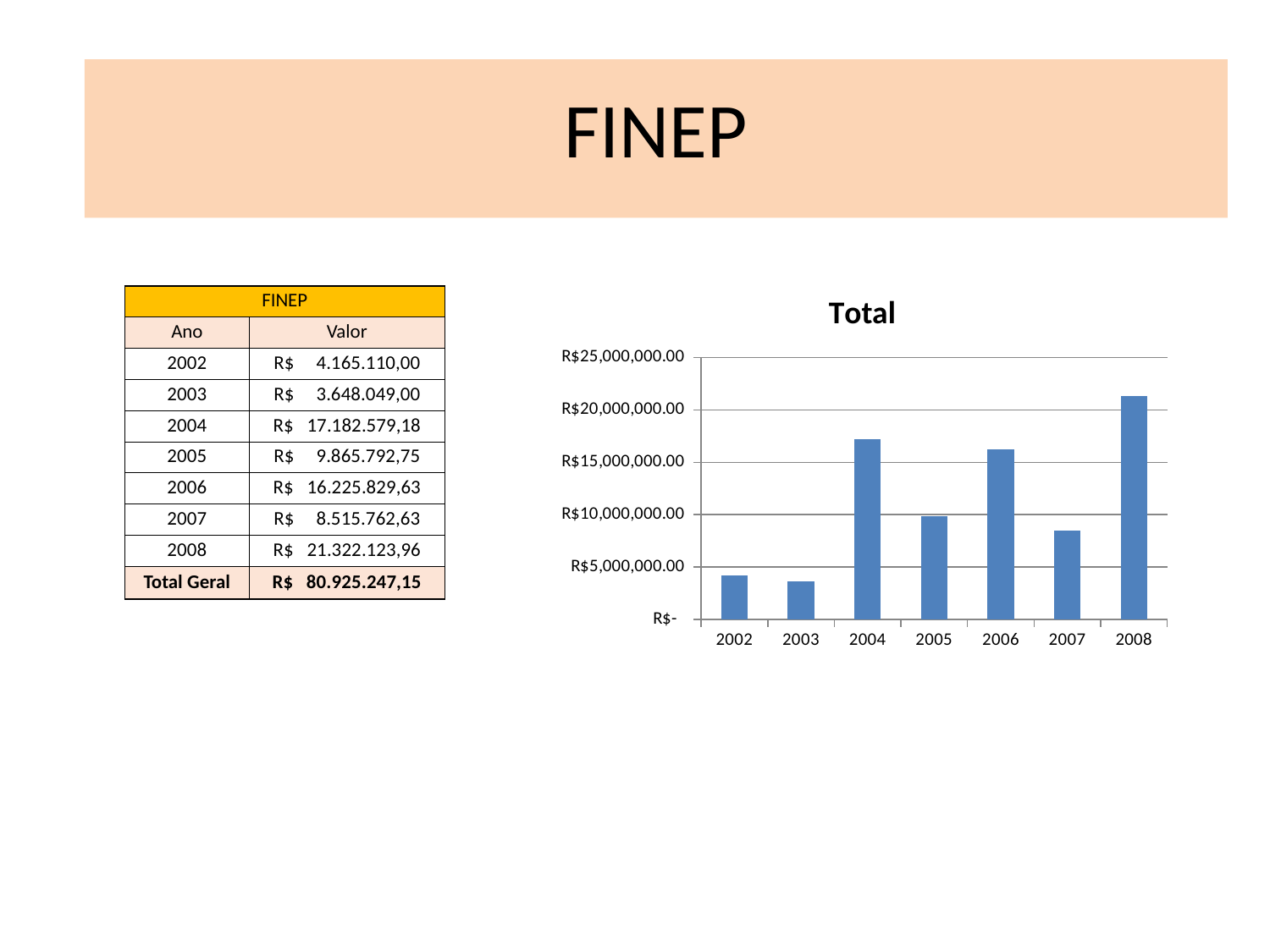
How many years are plotted on the chart? 7 What is the value for 2004? R$ 17.182.579,18 Is the value for 2007 greater or less than R$10,000,000.00? less What is the value for 2008? R$ 21.322.123,96 Which year has the lowest value in the chart? 2003 What kind of chart is shown on the slide? bar chart What is the value for 2002? R$ 4.165.110,00 What is the title of the chart? Total Which is larger, the value for 2004 or the value for 2006? 2004 Which year has the highest value in the chart? 2008 Is the value for 2008 greater or less than R$20,000,000.00? greater What is the difference between the values for 2008 and 2004? R$ 4.139.544,78